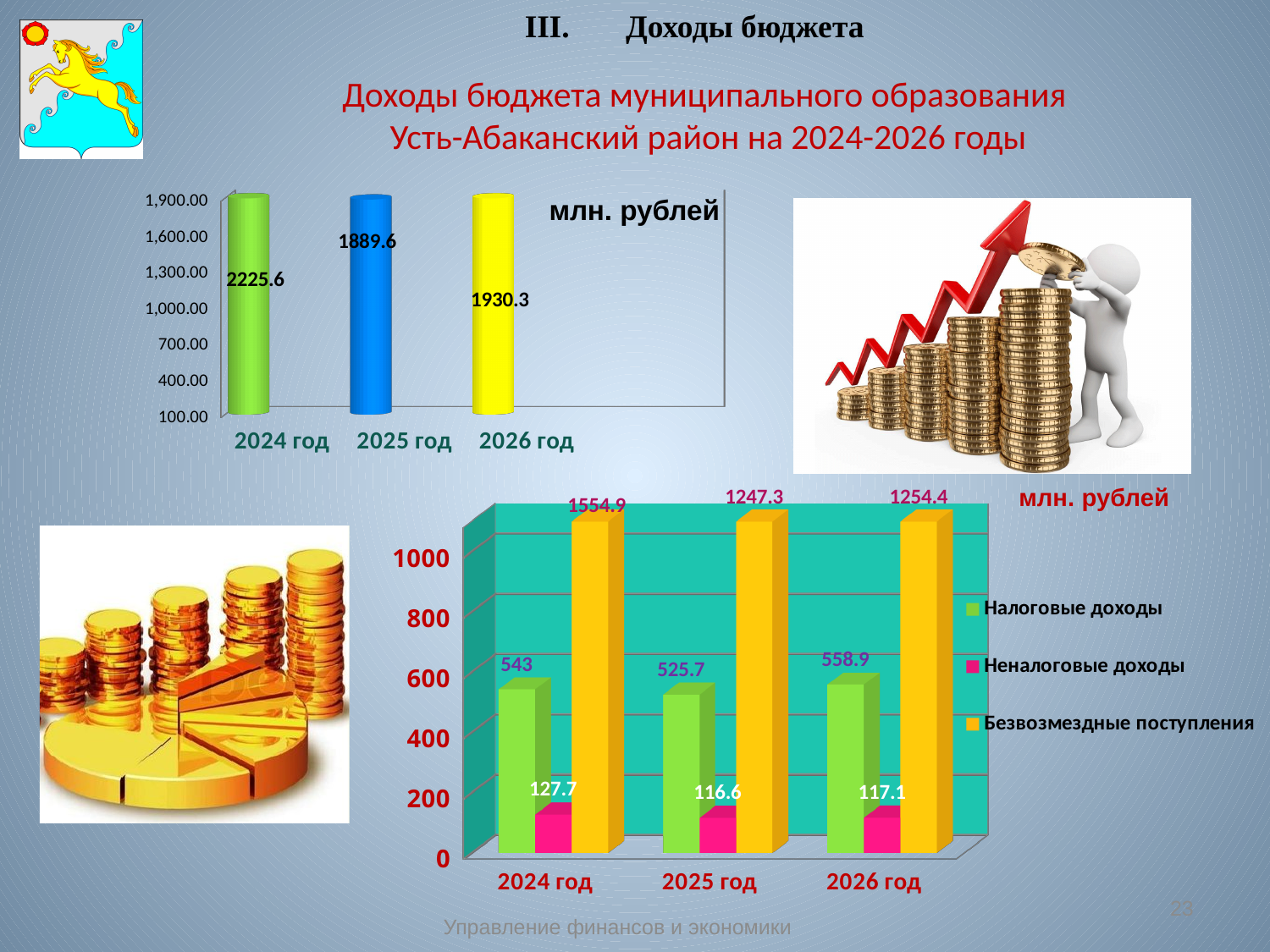
In the bottom chart, what is the value of Безвозмездные поступления for 2024 год? 1554.9 In the bottom chart, which year has the highest value of Налоговые доходы? 2026 год In the bottom chart, what is the value of Налоговые доходы for 2026 год? 558.9 In the bottom chart, what is the value of Неналоговые доходы for 2025 год? 116.6 In the top-left bar chart, what is the value for 2024 год? 2225.6 In the bottom chart, what is the difference between Безвозмездные поступления for 2024 год and 2025 год? 307.6 In the top-left bar chart, what is the value for 2025 год? 1889.6 In the top-left bar chart, which year has the lowest value? 2025 год In the top-left bar chart, which is larger: the value for 2026 год or the value for 2025 год? 2026 год What kind of chart is the bottom chart? Bar chart In the top-left bar chart, what is the difference between the values for 2024 год and 2025 год? 336.0 In the bottom chart, how many series does the legend list? 3